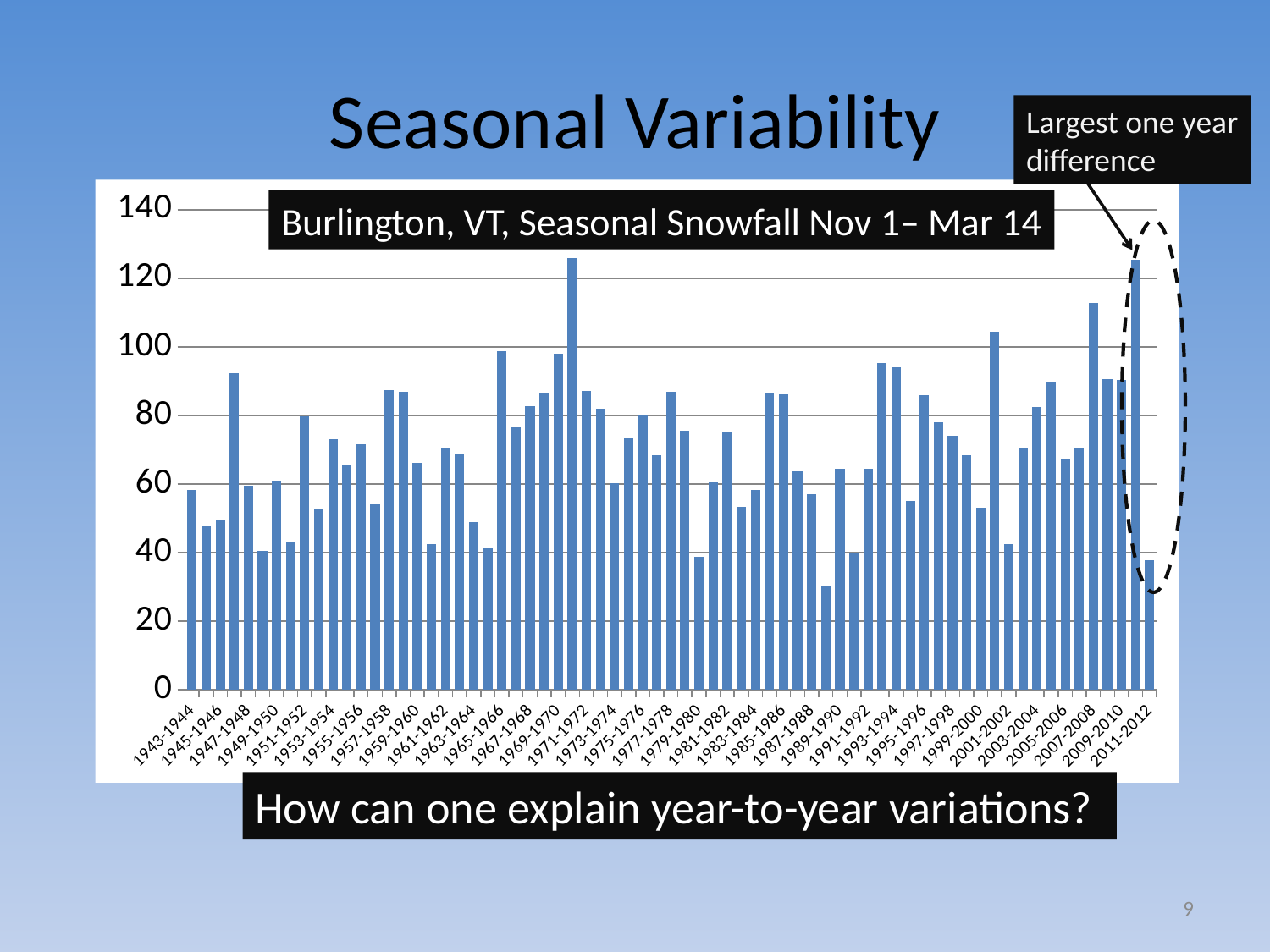
What is the title of the chart? Burlington, VT, Seasonal Snowfall Nov 1– Mar 14 Is the value for 2011-2012 greater or less than 40? less Which season has the larger value, 2009-2010 or 2011-2012? 2009-2010 Is the value for 1993-1994 greater or less than 80? greater Is the value for 1971-1972 greater or less than 120? less Which season has the lowest snowfall bar in the chart? 1988-1989 What kind of chart is shown on the slide? Bar chart Which season has the larger value, 1971-1972 or 1989-1990? 1971-1972 What does the annotation pointing to the circled bars at the right of the chart say? Largest one year difference